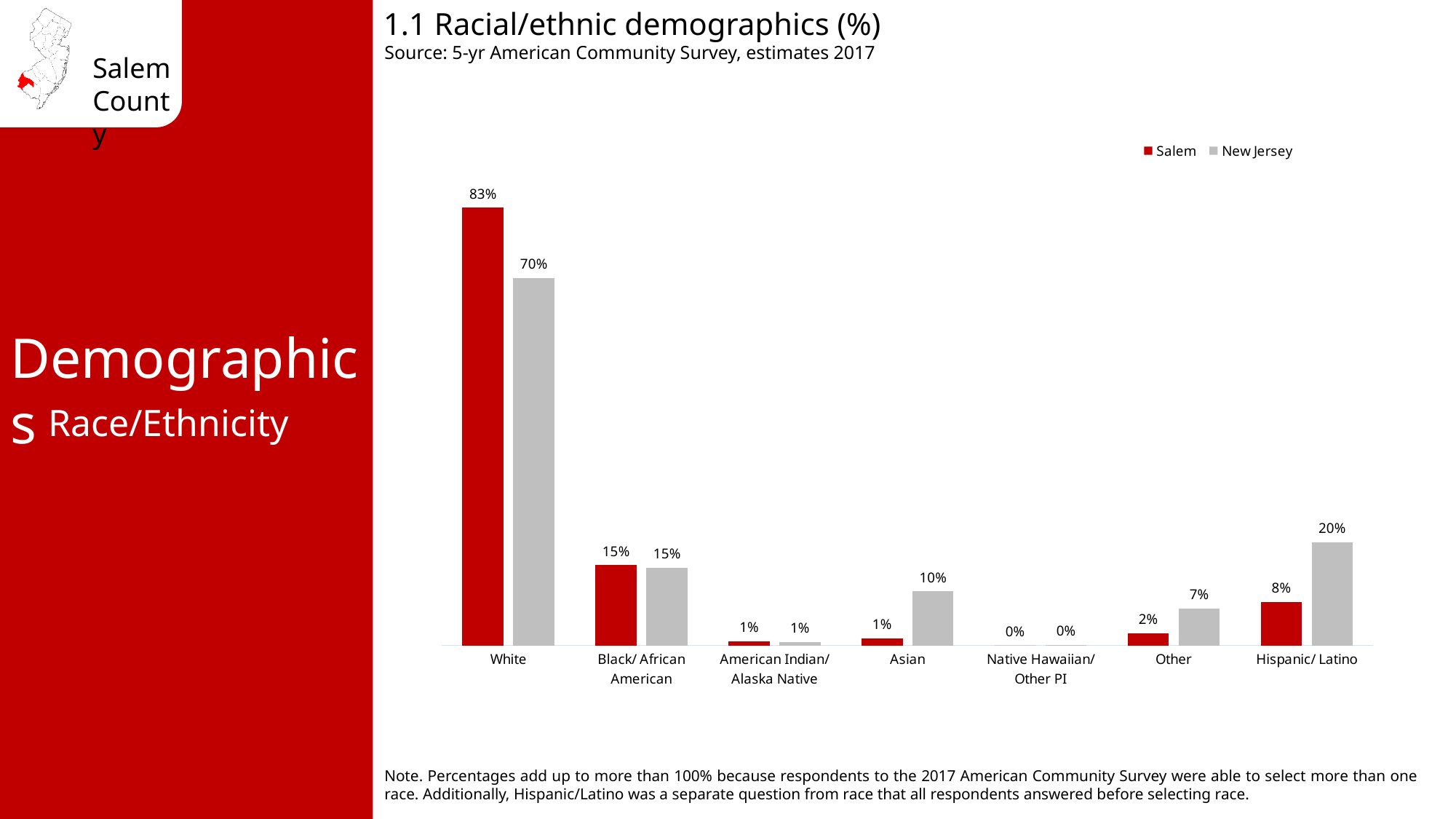
How many series does the legend list? 2 What is the New Jersey value for Asian? 10% How many categories are shown on the x axis? 7 What is the New Jersey value for Hispanic/ Latino? 20% What is the difference between the New Jersey and Salem values for Hispanic/ Latino? 12% Which category has the highest Salem value? White Which category has the lowest New Jersey value? Native Hawaiian/ Other PI What is the difference between the Salem and New Jersey values for White? 13% What is the Salem value for Other? 2% What kind of chart is shown on the slide? Bar chart What is the Salem value for White? 83% Which is larger for Asian, the Salem value or the New Jersey value? New Jersey